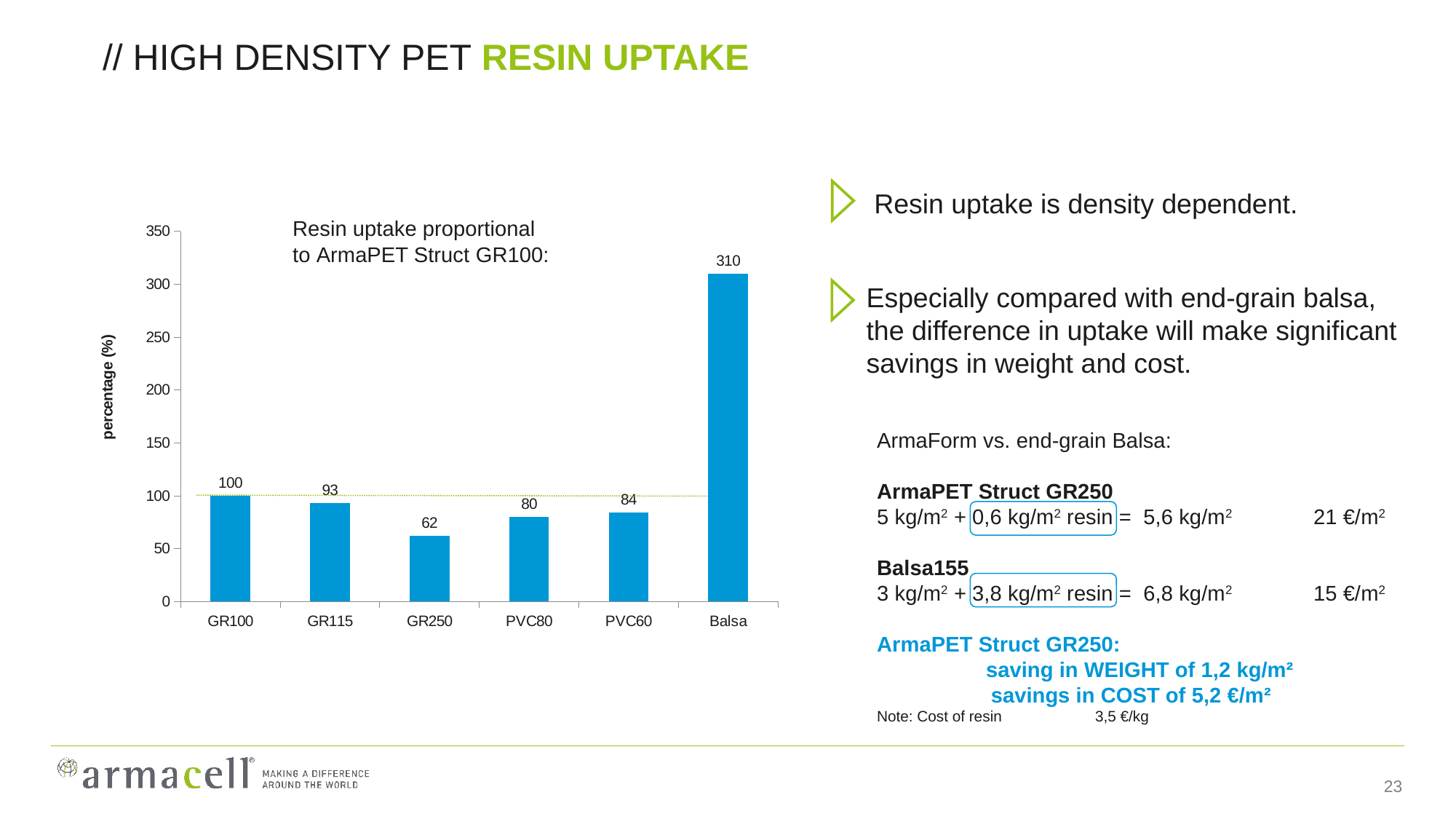
What is the difference between the values for Balsa and GR100? 210 Which category has the highest resin uptake? Balsa What is the resin uptake value for PVC80? 80 What is the label of the y axis of the chart? percentage (%) What kind of chart is shown on the slide? Bar chart What is the difference between the values for PVC60 and PVC80? 4 Is the value for Balsa greater or less than 300? greater Which is larger, the value for GR115 or the value for PVC60? GR115 Which category has the lowest resin uptake? GR250 What is the resin uptake value for GR250? 62 How many categories are shown on the x axis of the chart? 6 What is the resin uptake value for Balsa? 310